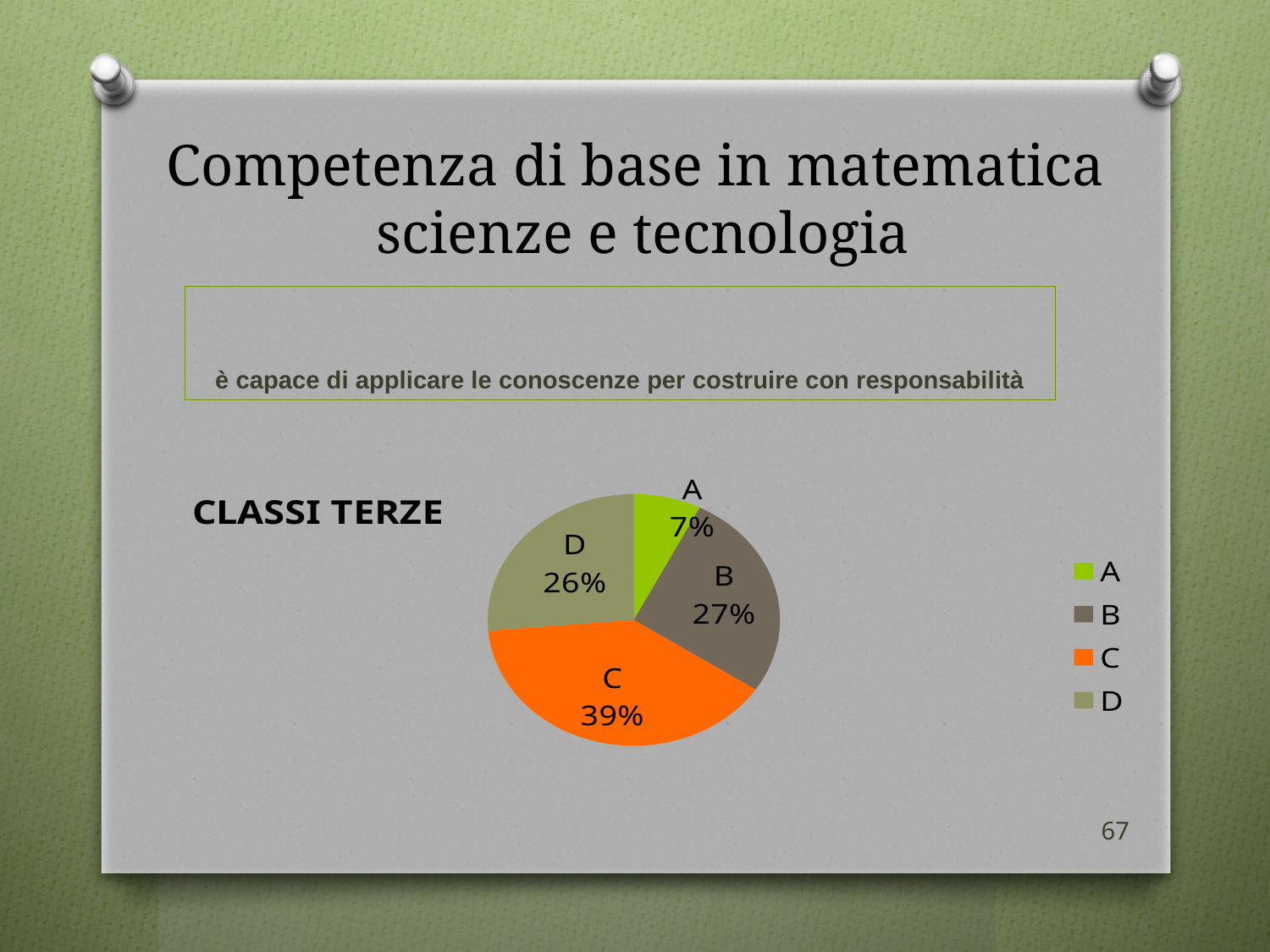
What percentage does slice D represent in the pie chart? 26% What percentage does slice A represent in the pie chart? 7% What kind of chart is shown on the slide? pie chart How many slices does the pie chart have? 4 Which slice of the pie chart is the smallest? A Which slice of the pie chart is the largest? C What percentage does slice B represent in the pie chart? 27% What is the difference in percentage points between slice C and slice A? 32 What is the difference in percentage points between slice B and slice D? 1 What colour is slice C in the pie chart? orange Which is larger, slice C or slice D? C What percentage does slice C represent in the pie chart? 39%